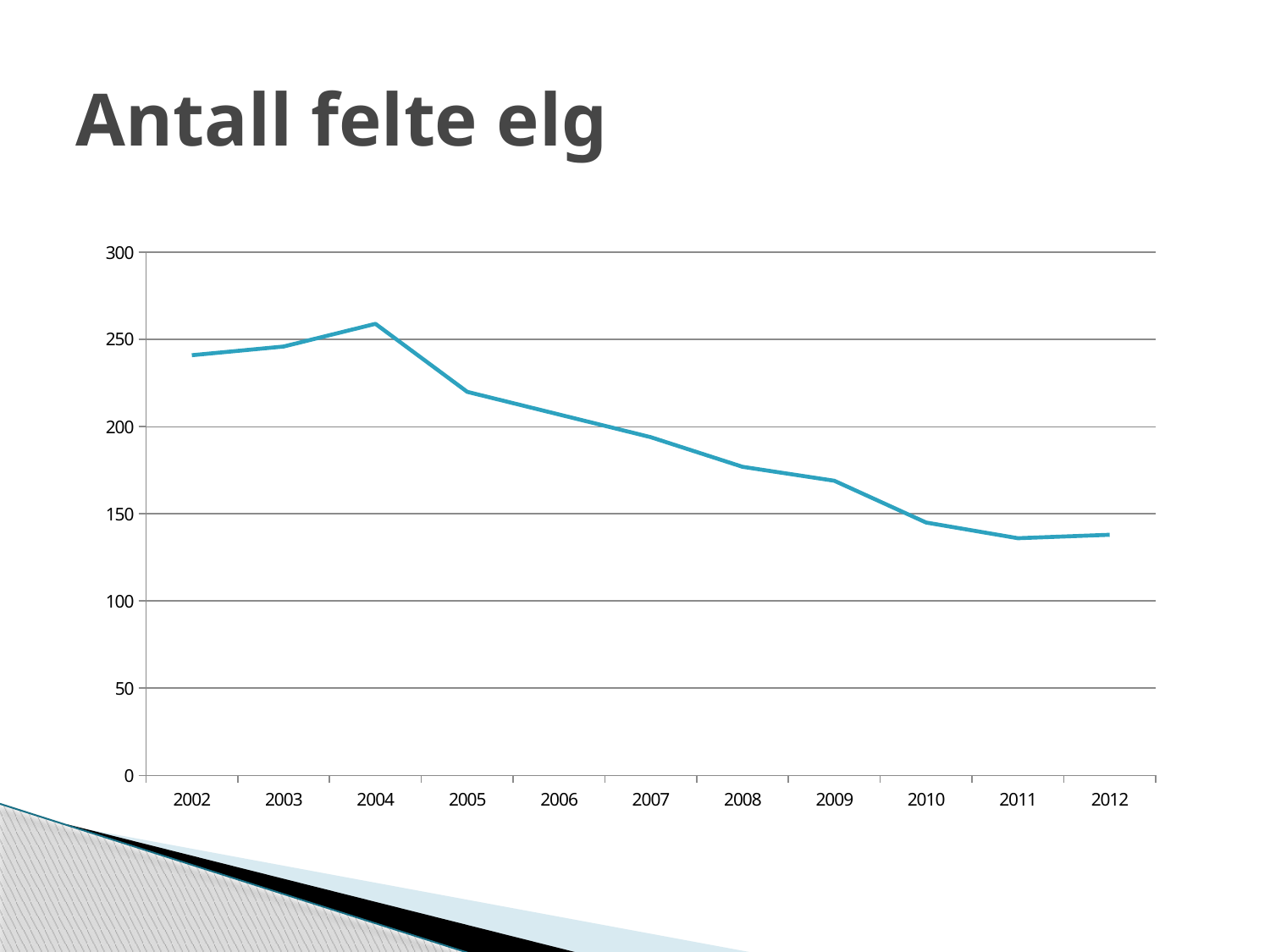
What kind of chart is shown on the slide? line chart Is the value for 2008 greater or less than 200? less Which is larger, the value for 2011 or the value for 2003? 2003 Is the value for 2005 greater or less than 250? less Do the values generally rise or fall from 2004 to 2012? fall Which year has the highest value? 2004 Is the value for 2004 greater or less than 250? greater What is the title of the chart on the slide? Antall felte elg How many years are plotted along the x axis? 11 Which is larger, the value for 2004 or the value for 2009? 2004